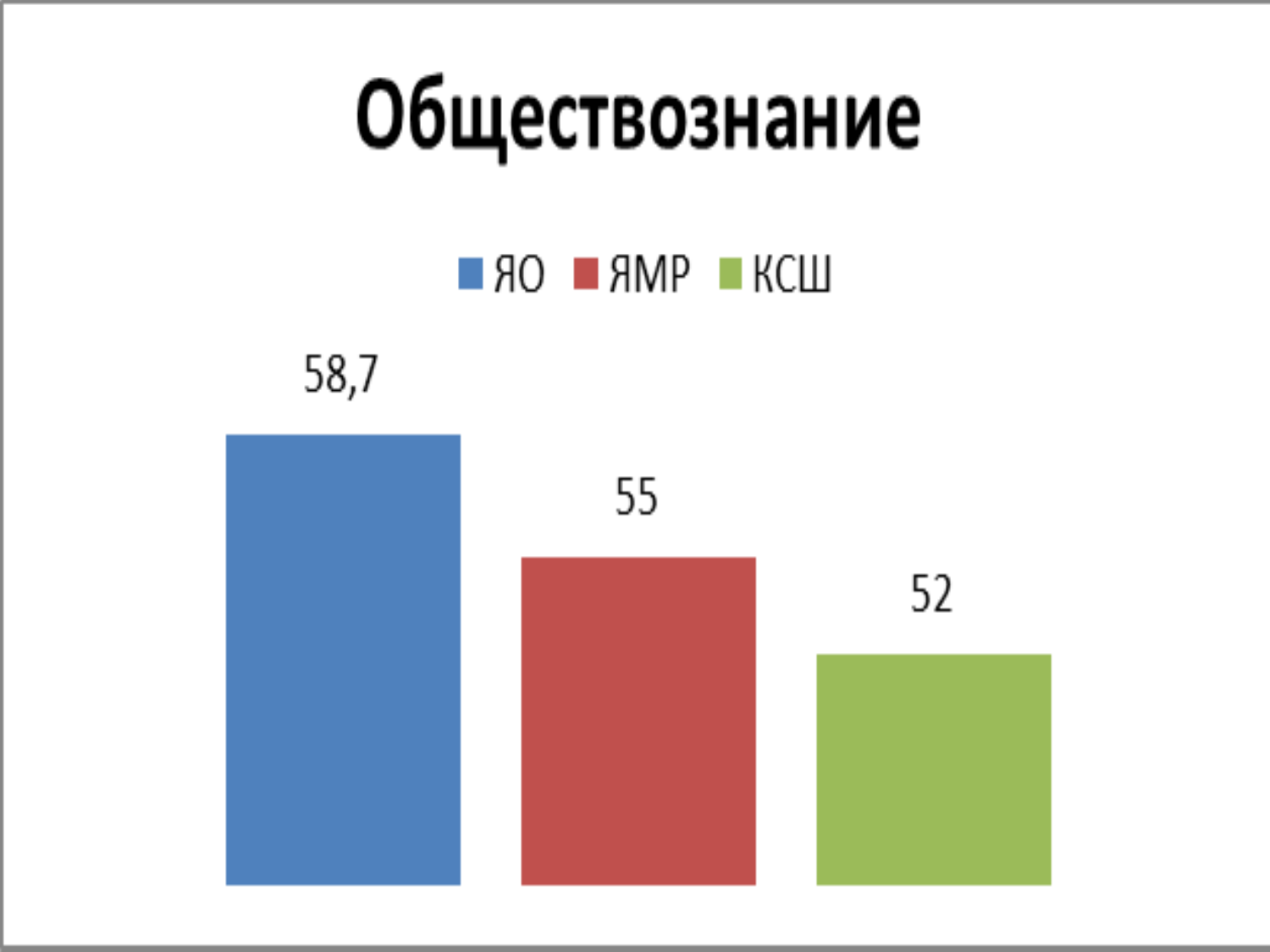
What is the value for КСШ? 52 What is the value for ЯО? 58,7 What is the title of the chart? Обществознание How many series does the legend list? 3 What kind of chart is shown on the slide? bar chart How many bars are plotted on the chart? 3 What is the difference between the values for ЯМР and КСШ? 3 What is the difference between the values for ЯО and ЯМР? 3,7 Which series has the highest value? ЯО Which series has the lowest value? КСШ Which is larger, the value for ЯО or the value for КСШ? ЯО What is the value for ЯМР? 55